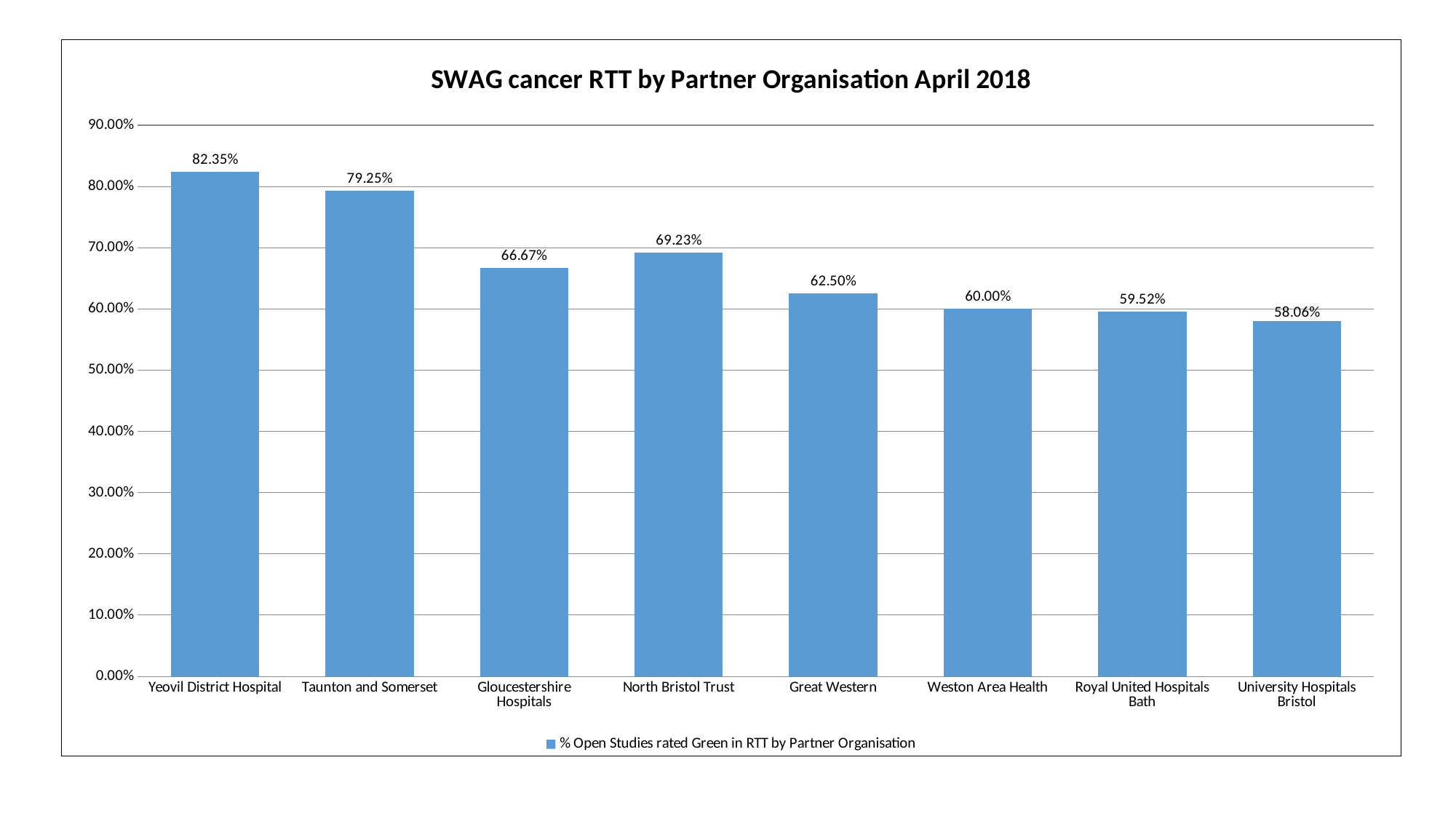
How many series does the legend list? 1 What is the difference between the values for Yeovil District Hospital and Taunton and Somerset? 3.10% What kind of chart is shown on the slide? Bar chart How many partner organisations are shown on the chart? 8 What is the title of the chart? SWAG cancer RTT by Partner Organisation April 2018 What is the value for Yeovil District Hospital? 82.35% Which partner organisation has the lowest value? University Hospitals Bristol What is the value for North Bristol Trust? 69.23% What is the value for Royal United Hospitals Bath? 59.52% Which partner organisation has the highest value? Yeovil District Hospital Is the value for Great Western greater or less than 70.00%? less Which is larger, the value for Gloucestershire Hospitals or the value for North Bristol Trust? North Bristol Trust